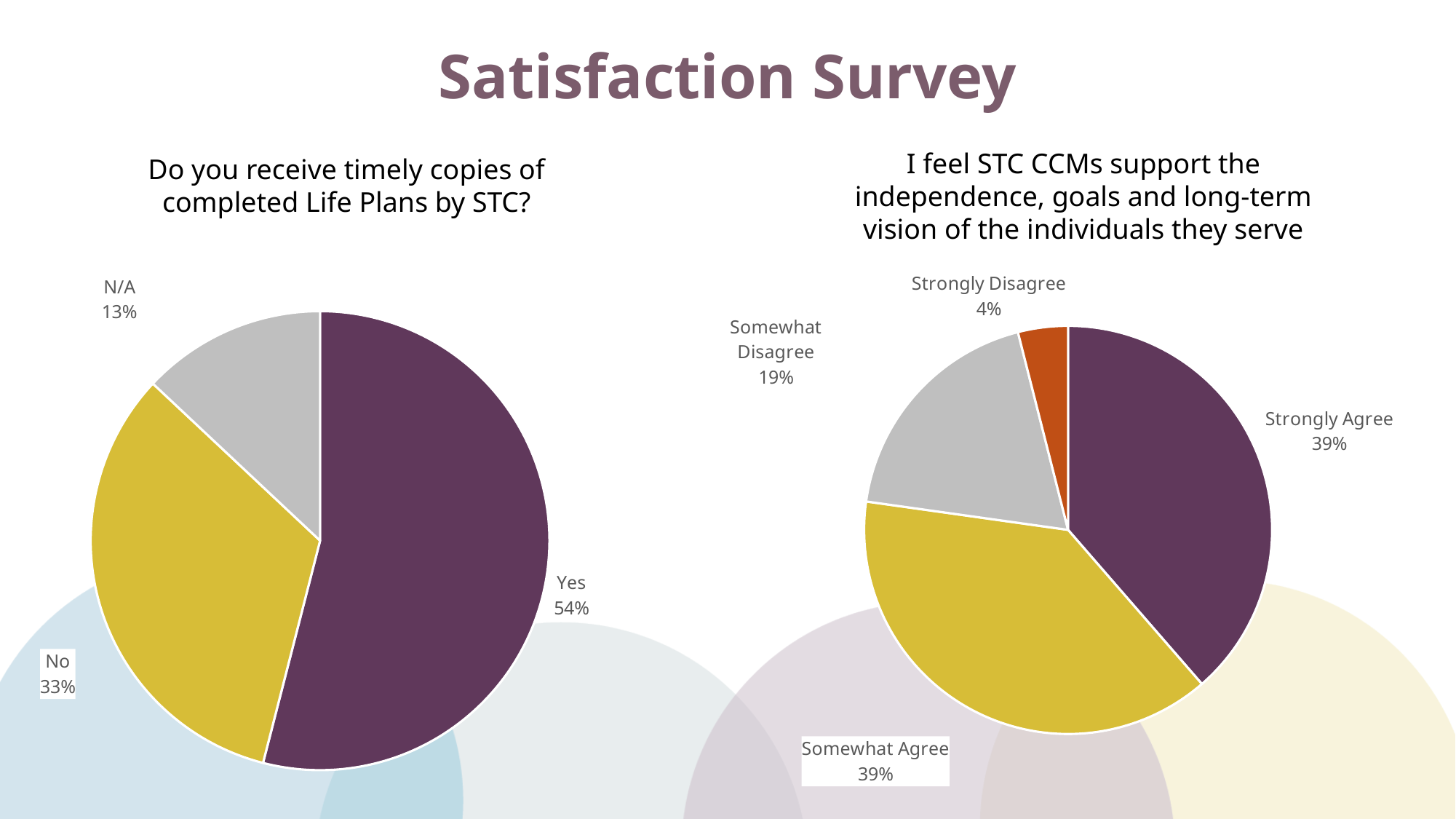
What type of chart is used for 'Do you receive timely copies of completed Life Plans by STC?'? Pie chart How many slices does the left pie chart, 'Do you receive timely copies of completed Life Plans by STC?', have? 3 In the left chart, 'Do you receive timely copies of completed Life Plans by STC?', what is the difference in percentage points between Yes and No? 21 In the left chart, 'Do you receive timely copies of completed Life Plans by STC?', which response has the smallest share? N/A In the right chart, 'I feel STC CCMs support the independence, goals and long-term vision of the individuals they serve', which is larger: Somewhat Disagree or Strongly Disagree? Somewhat Disagree In the left chart, 'Do you receive timely copies of completed Life Plans by STC?', what percentage answered Yes? 54% In the left chart, 'Do you receive timely copies of completed Life Plans by STC?', what percentage answered No? 33% In the right chart, 'I feel STC CCMs support the independence, goals and long-term vision of the individuals they serve', which response has the smallest share? Strongly Disagree In the right chart, 'I feel STC CCMs support the independence, goals and long-term vision of the individuals they serve', what percentage chose Strongly Agree? 39% In the left chart, 'Do you receive timely copies of completed Life Plans by STC?', which response has the largest share? Yes How many slices does the right pie chart, 'I feel STC CCMs support the independence, goals and long-term vision of the individuals they serve', have? 4 In the right chart, 'I feel STC CCMs support the independence, goals and long-term vision of the individuals they serve', what percentage chose Somewhat Disagree? 19%